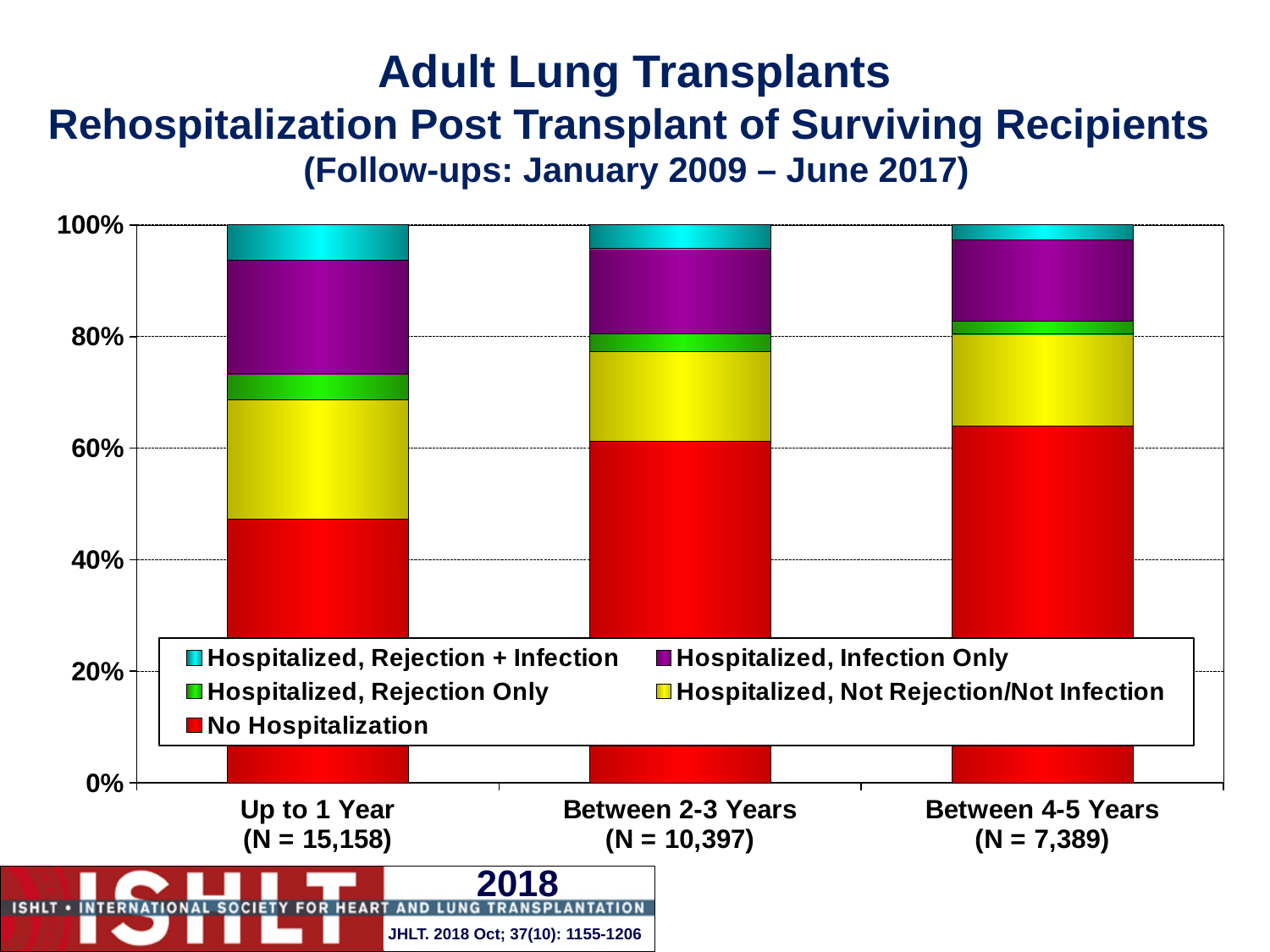
Is the No Hospitalization share for Up to 1 Year greater or less than 60%? less Which time period has the lowest No Hospitalization share? Up to 1 Year Is the No Hospitalization share for Between 4-5 Years greater or less than 80%? less Is the No Hospitalization share for Between 2-3 Years greater or less than 40%? greater What is the total of each stacked bar? 100% What kind of chart is shown on the slide? Stacked bar chart How many categories (time periods) are shown on the x axis? 3 Which is larger, the No Hospitalization share for Up to 1 Year or for Between 2-3 Years? Between 2-3 Years Does the No Hospitalization share rise or fall from Up to 1 Year to Between 4-5 Years? Rises How many series does the legend list? 5 What is the N for the Up to 1 Year category? 15,158